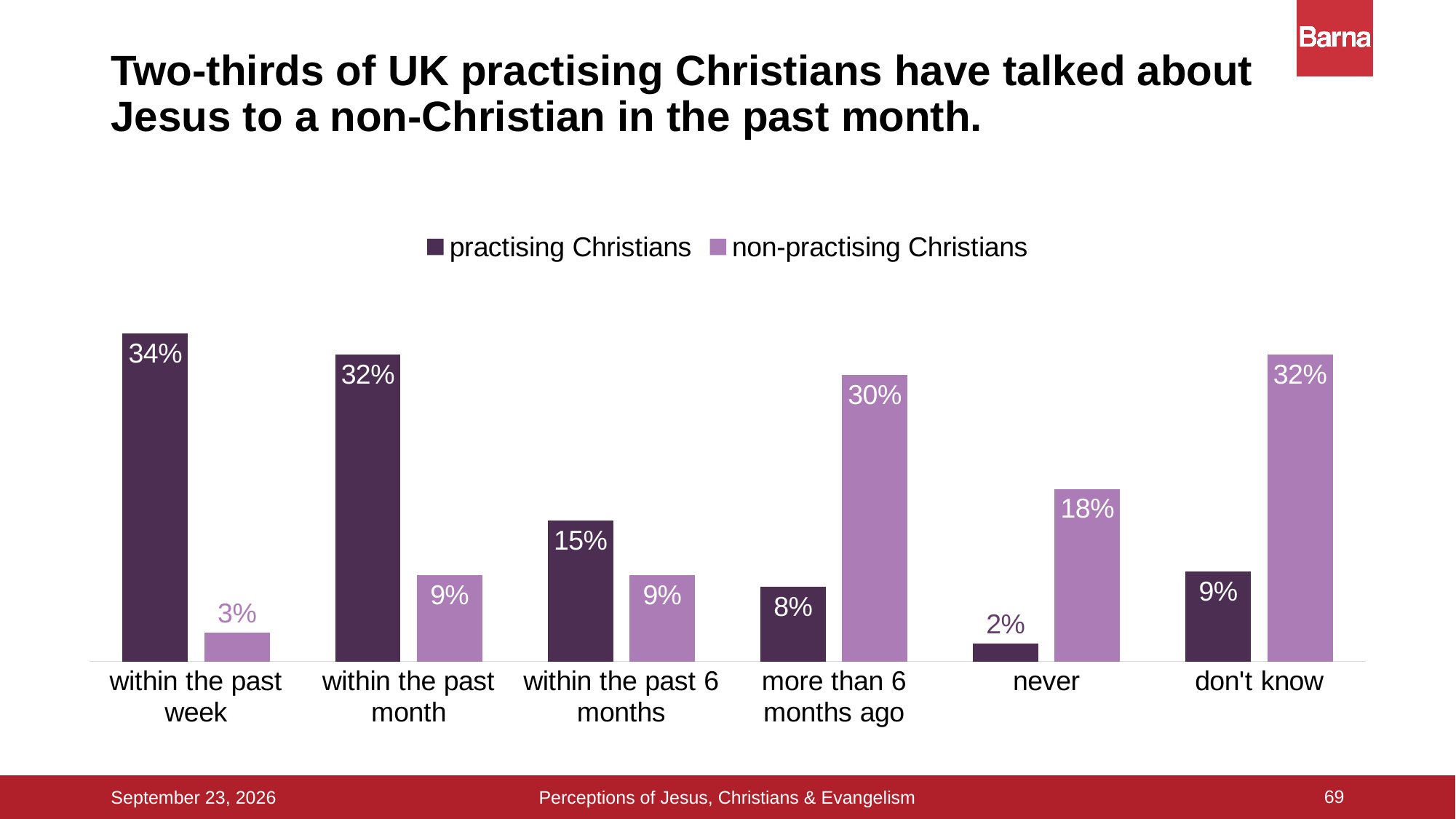
Which category has the lowest value for practising Christians? never Which category has the highest value for practising Christians? within the past week What is the difference between practising Christians and non-practising Christians in the 'within the past month' category? 23% Which category has the lowest value for non-practising Christians? within the past week What is the value for non-practising Christians in the 'never' category? 18% How many series does the legend list? 2 What is the difference between the practising Christians values for 'within the past week' and 'within the past 6 months'? 19% What is the value for practising Christians in the 'within the past week' category? 34% What is the value for non-practising Christians in the 'more than 6 months ago' category? 30% What kind of chart is shown on the slide? bar chart In the 'don't know' category, which series has the larger value, practising Christians or non-practising Christians? non-practising Christians How many categories are shown on the x axis? 6